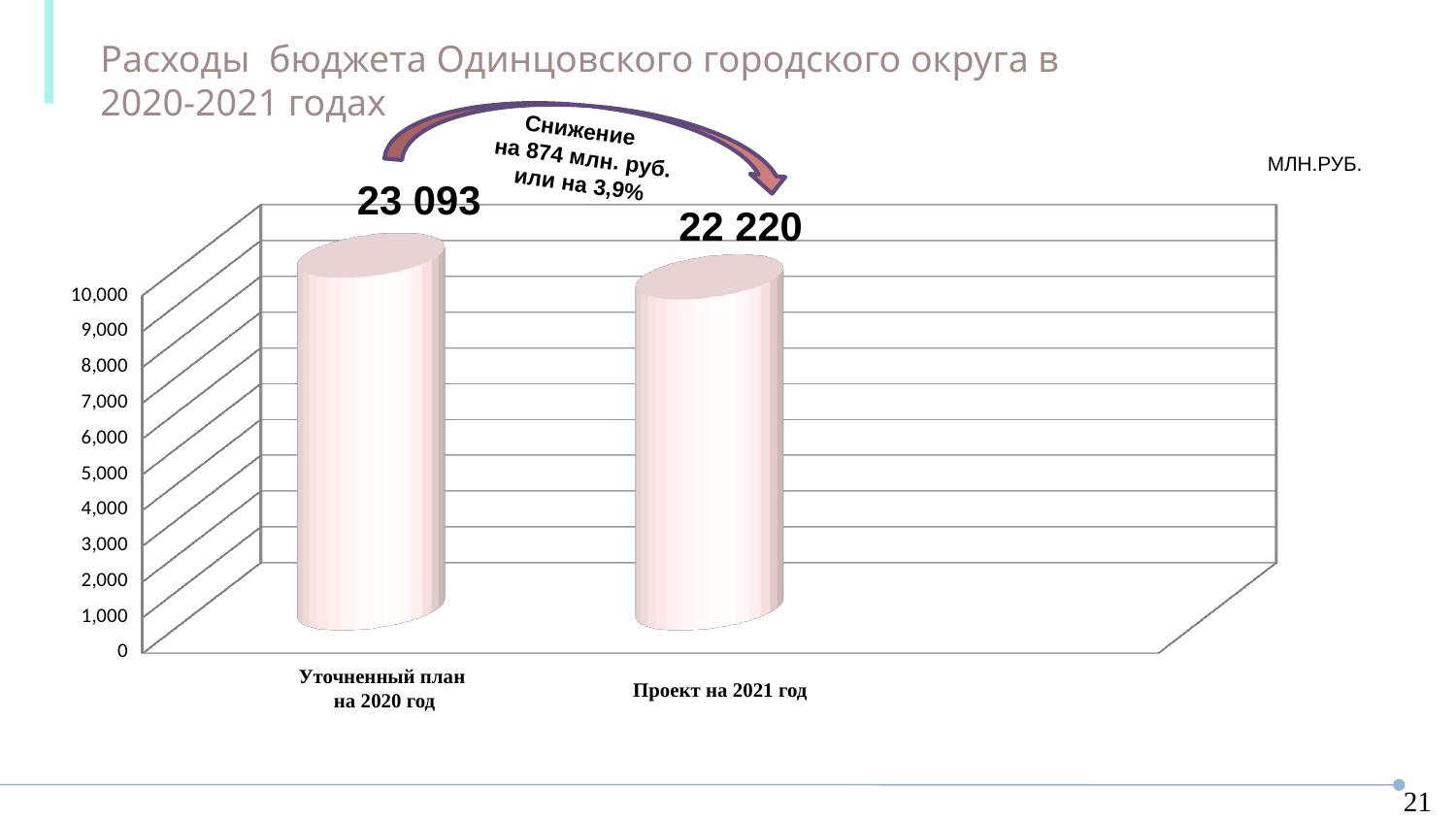
What is the value for 'Проект на 2021 год'? 22 220 Which is larger: the value for 'Уточненный план на 2020 год' or for 'Проект на 2021 год'? Уточненный план на 2020 год What kind of chart is shown on the slide? bar chart Which category has the lowest value? Проект на 2021 год How many categories are shown in the chart? 2 Do the values rise or fall from 2020 to 2021? fall What unit of measurement is indicated for the chart values? МЛН.РУБ. What is the value for 'Уточненный план на 2020 год'? 23 093 According to the annotation on the chart, by what percentage do expenditures decrease from 2020 to 2021? 3,9% Which category has the highest value? Уточненный план на 2020 год